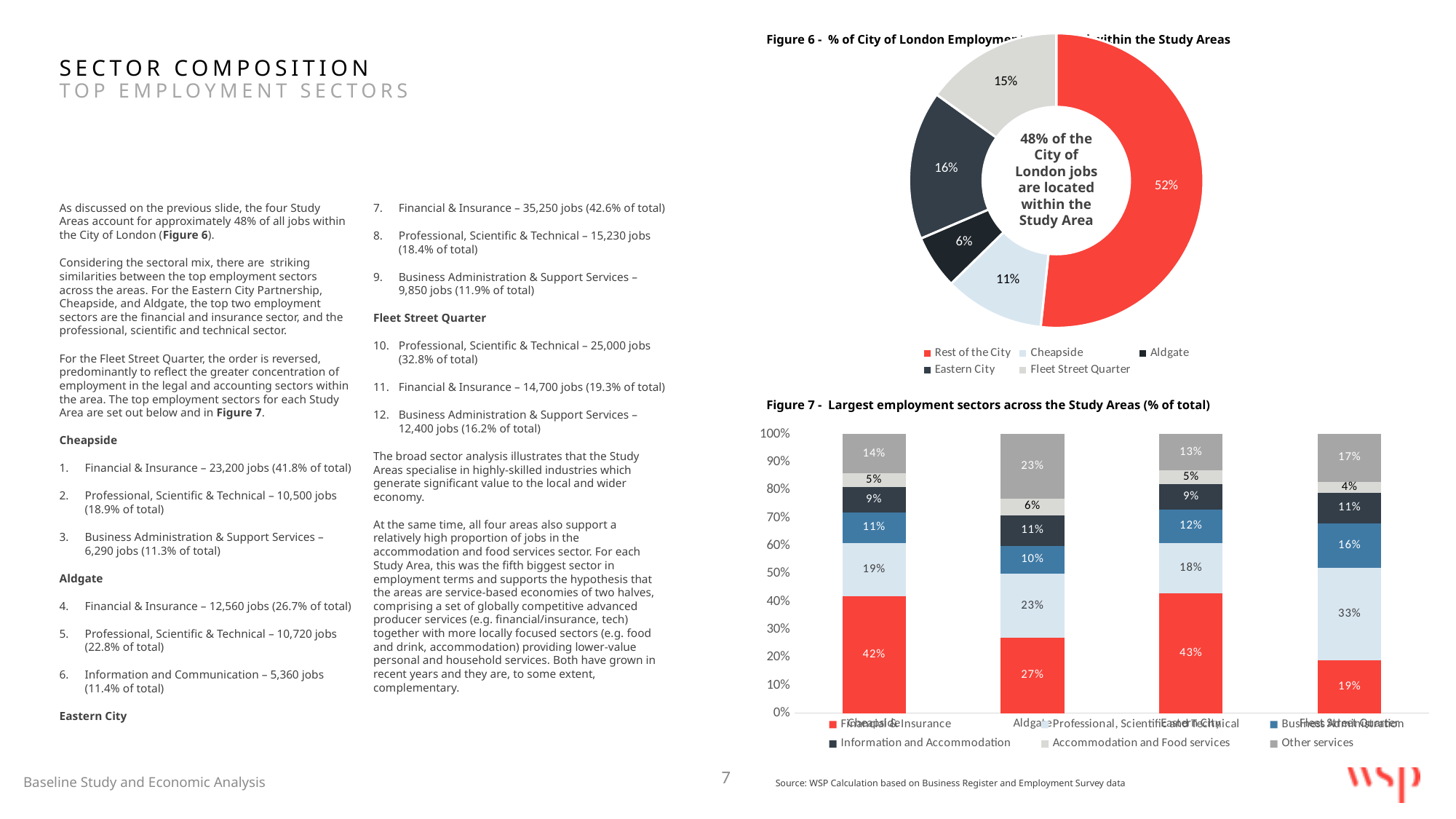
In Figure 6, which study area has the smallest share? Aldgate In Figure 7, which study area has the highest Financial & Insurance share? Eastern City In Figure 6, what percentage is shown for Rest of the City? 52% How many series does the legend of Figure 7 list? 6 In Figure 7, is the Other services share larger for Aldgate or for Cheapside? Aldgate What kind of chart is Figure 6? doughnut chart What kind of chart is Figure 7? bar chart According to the text in the centre of Figure 6, what percentage of City of London jobs are located within the Study Area? 48% In Figure 6, what is the difference between the Eastern City share and the Fleet Street Quarter share? 1% How many entries does the legend of Figure 6 list? 5 In Figure 7, what is the Financial & Insurance share for Cheapside? 42% In Figure 7, what is the Professional, Scientific and Technical share for Fleet Street Quarter? 33%